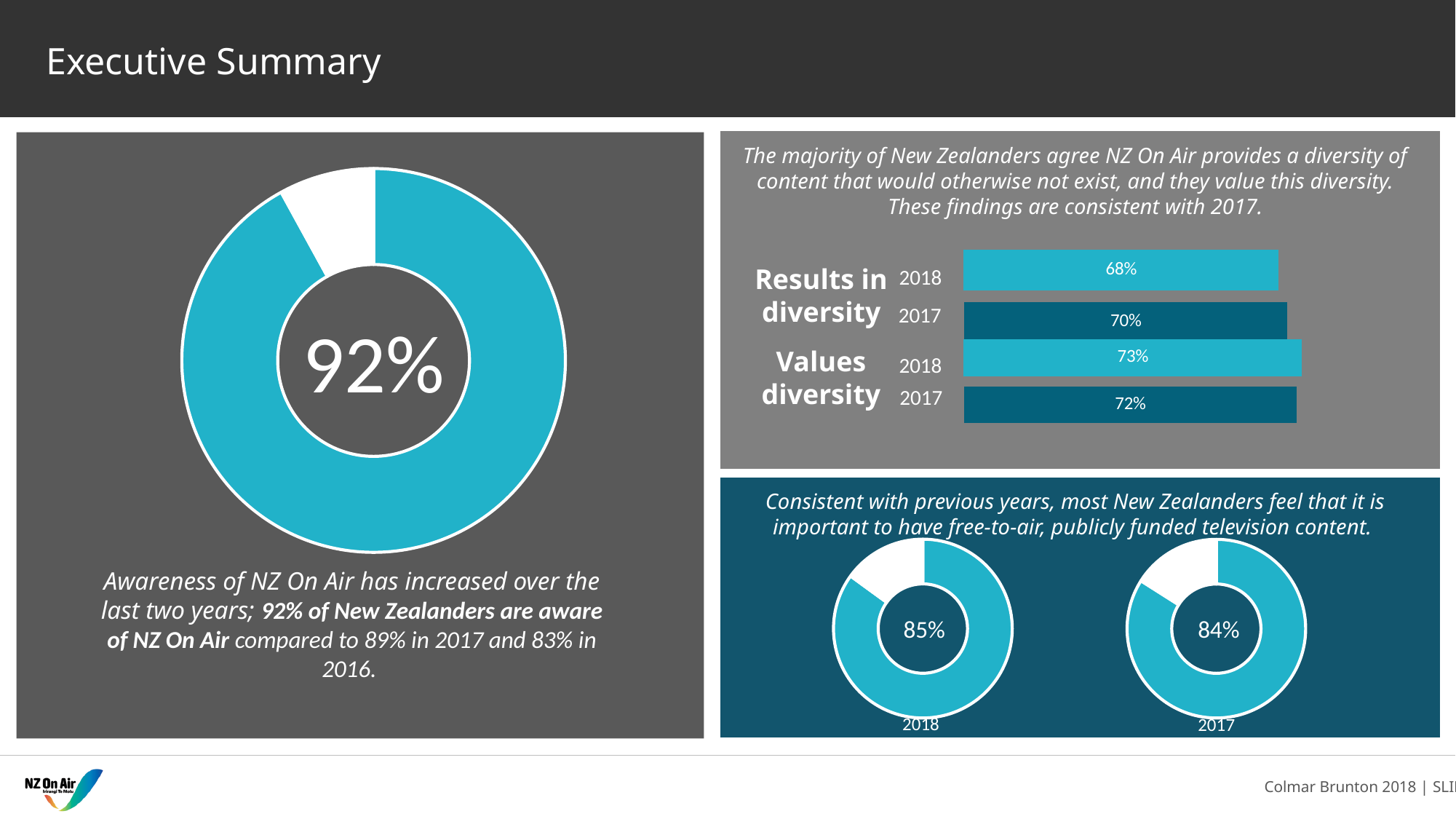
In the bar chart on the right of the slide, what is the difference between Results in diversity in 2017 and in 2018? 2% In the bar chart on the right of the slide, which bar has the lowest value? Results in diversity 2018 In the two small donut charts at the bottom right of the slide, what is the value for 2018? 85% In the bar chart on the right of the slide, which bar has the highest value? Values diversity 2018 What kind of chart is the large chart on the left of the slide? Donut chart In the bar chart on the right of the slide, what is the value for Results in diversity in 2017? 70% In the bar chart on the right of the slide, what is the value for Values diversity in 2017? 72% In the bar chart on the right of the slide, what is the value for Values diversity in 2018? 73% What value is shown in the centre of the large donut chart on the left of the slide? 92% In the two small donut charts at the bottom right of the slide, what is the value for 2017? 84% In the bar chart on the right of the slide, how many bars are plotted? 4 In the bar chart on the right of the slide, what is the value for Results in diversity in 2018? 68%